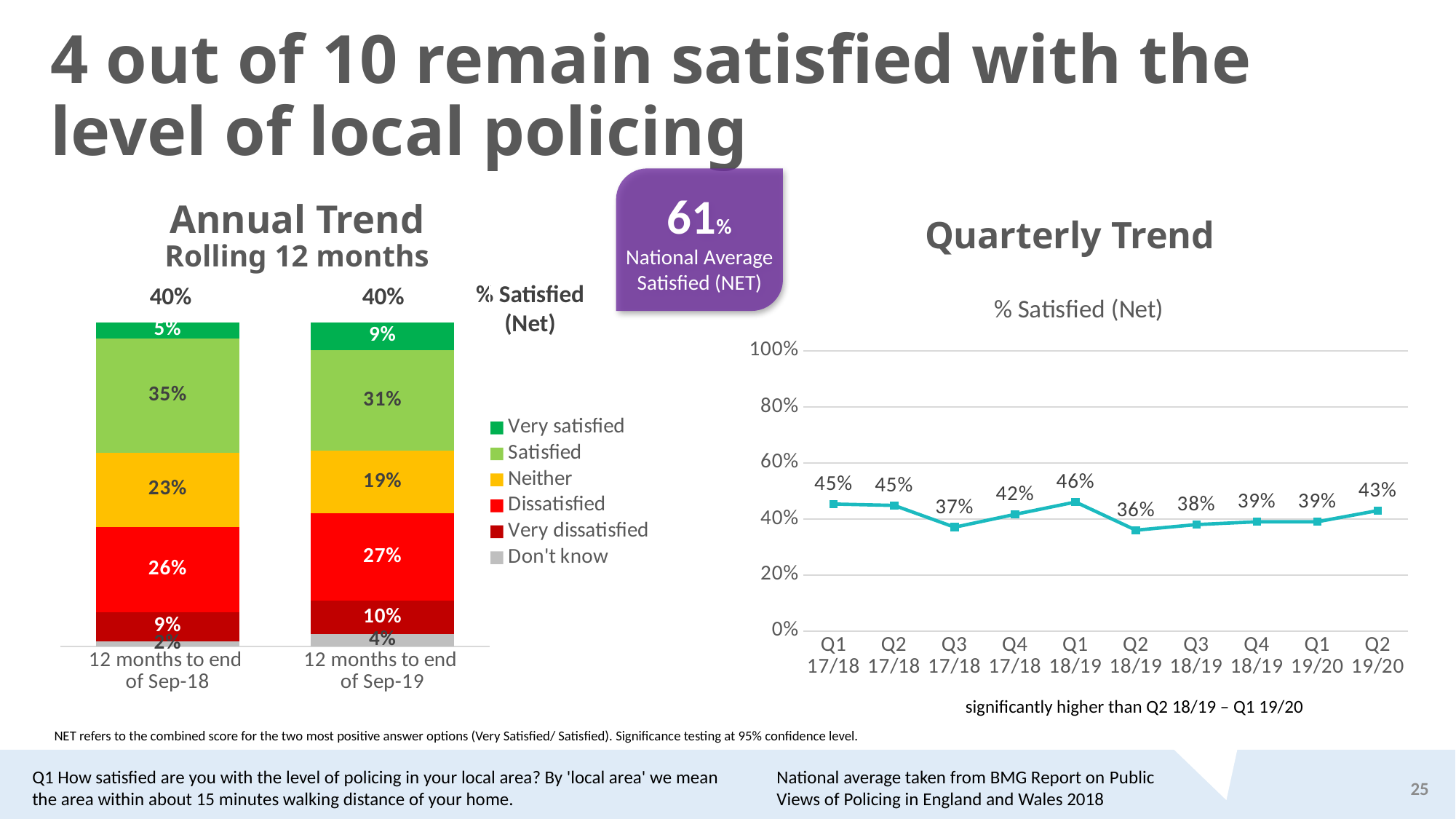
In the Annual Trend chart, what percentage were Very satisfied in the 12 months to end of Sep-19? 9% In the Annual Trend chart, what percentage were Dissatisfied in the 12 months to end of Sep-18? 26% In the Quarterly Trend chart, how many quarters are plotted? 10 In the Quarterly Trend chart, which quarter has the highest % Satisfied (Net)? Q1 18/19 In the Annual Trend chart, which is larger: the Neither share for Sep-18 or for Sep-19? Sep-18 In the Annual Trend chart, how many series does the legend list? 6 In the Annual Trend chart, what is the difference between the Satisfied share for Sep-18 and Sep-19? 4% What kind of chart is the Quarterly Trend chart? Line chart In the Quarterly Trend chart, what is the % Satisfied (Net) for Q2 19/20? 43% In the Quarterly Trend chart, what is the difference between Q1 18/19 and Q2 18/19? 10% In the Annual Trend chart, what is the % Satisfied (Net) for the 12 months to end of Sep-19? 40% In the Quarterly Trend chart, which quarter has the lowest % Satisfied (Net)? Q2 18/19